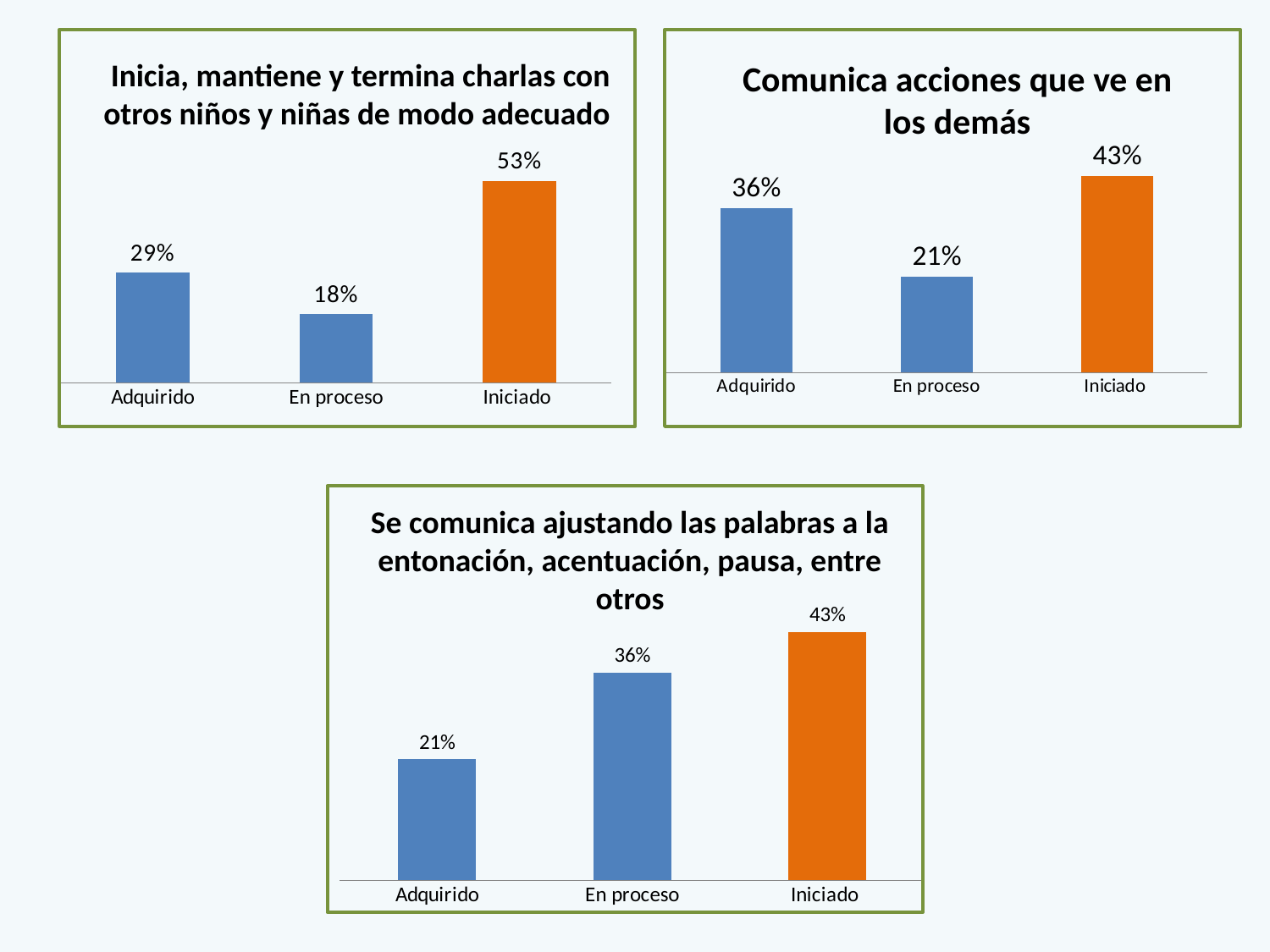
In the chart titled 'Inicia, mantiene y termina charlas con otros niños y niñas de modo adecuado', which category has the lowest value? En proceso In the chart titled 'Comunica acciones que ve en los demás', which is larger, Adquirido or En proceso? Adquirido In the chart titled 'Se comunica ajustando las palabras a la entonación, acentuación, pausa, entre otros', what is the difference between Iniciado and Adquirido? 22% In the chart titled 'Inicia, mantiene y termina charlas con otros niños y niñas de modo adecuado', what is the difference between Iniciado and Adquirido? 24% In the chart titled 'Se comunica ajustando las palabras a la entonación, acentuación, pausa, entre otros', do the values rise or fall from Adquirido to Iniciado? rise In the chart titled 'Se comunica ajustando las palabras a la entonación, acentuación, pausa, entre otros', what is the value for En proceso? 36% How many categories does the chart titled 'Comunica acciones que ve en los demás' show? 3 What kind of chart is the chart titled 'Inicia, mantiene y termina charlas con otros niños y niñas de modo adecuado'? bar chart In the chart titled 'Comunica acciones que ve en los demás', which category has the highest value? Iniciado In the chart titled 'Inicia, mantiene y termina charlas con otros niños y niñas de modo adecuado', what is the value for Iniciado? 53% In the chart titled 'Se comunica ajustando las palabras a la entonación, acentuación, pausa, entre otros', which category has the lowest value? Adquirido In the chart titled 'Comunica acciones que ve en los demás', what is the value for Adquirido? 36%